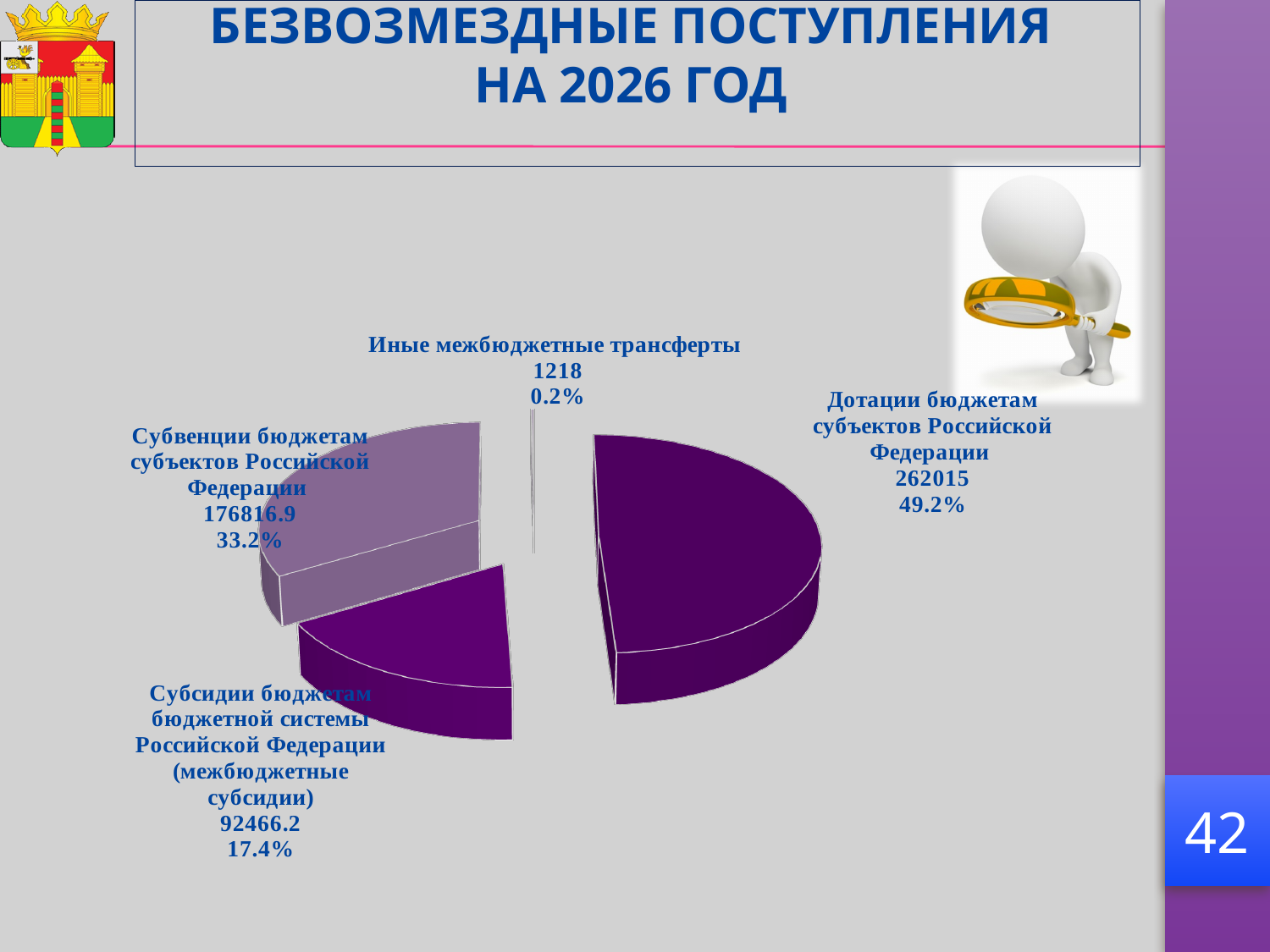
What share of the pie does Субвенции бюджетам субъектов Российской Федерации represent? 33.2% Which category has the smallest share of the pie? Иные межбюджетные трансферты What is the value for Дотации бюджетам субъектов Российской Федерации? 262015 What is the difference between the values for Дотации бюджетам субъектов Российской Федерации and Субвенции бюджетам субъектов Российской Федерации? 85198.1 What is the title of the slide containing the chart? БЕЗВОЗМЕЗДНЫЕ ПОСТУПЛЕНИЯ НА 2026 ГОД What is the value for Субсидии бюджетам бюджетной системы Российской Федерации (межбюджетные субсидии)? 92466.2 What is the value for Иные межбюджетные трансферты? 1218 How many slices does the pie chart have? 4 Which category has the largest share of the pie? Дотации бюджетам субъектов Российской Федерации What is the value for Субвенции бюджетам субъектов Российской Федерации? 176816.9 What share of the pie does Субсидии бюджетам бюджетной системы Российской Федерации (межбюджетные субсидии) represent? 17.4% What type of chart is shown on the slide? Pie chart